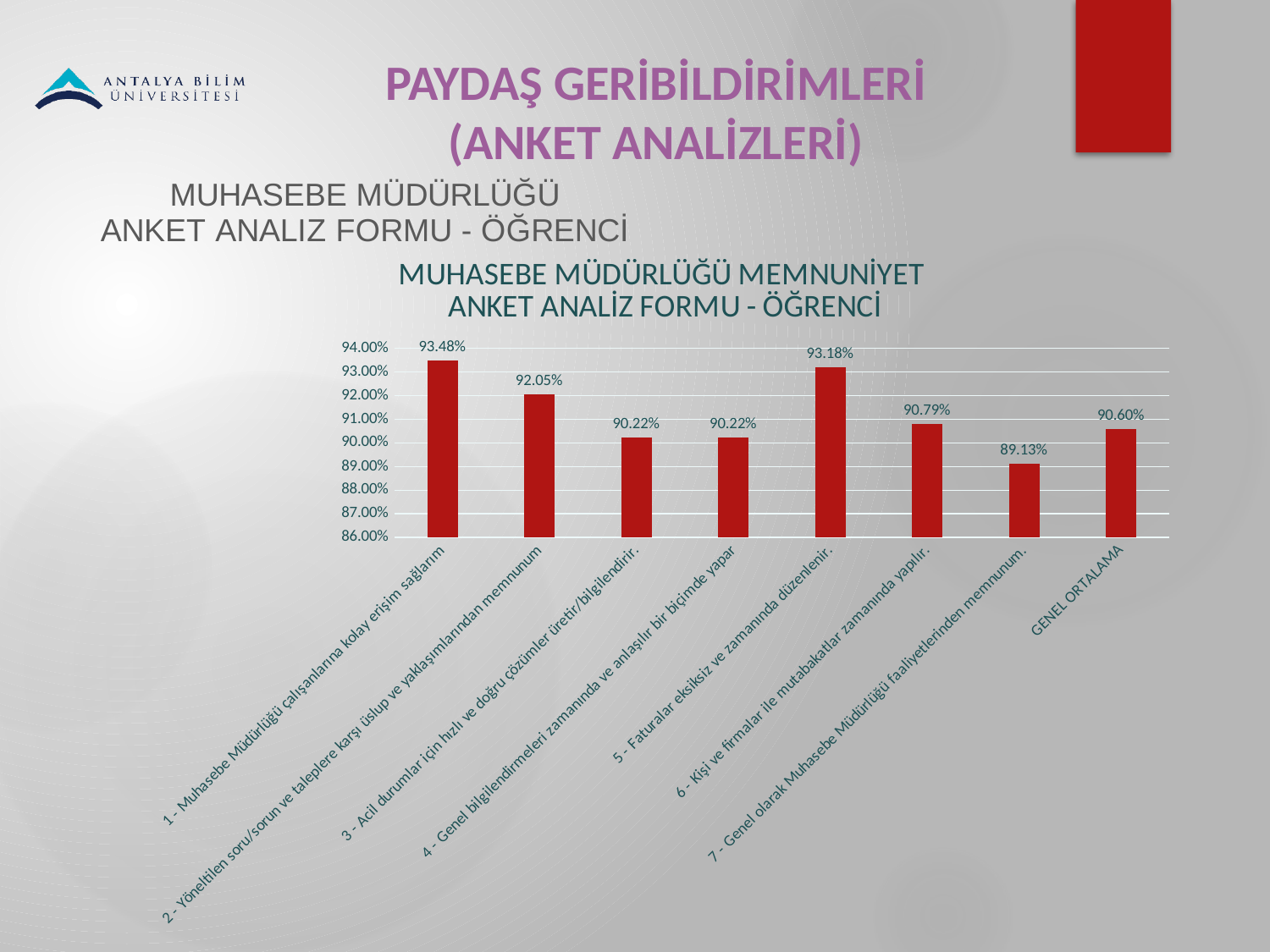
Which category has the highest value? 1 - Muhasebe Müdürlüğü çalışanlarına kolay erişim sağlarım What kind of chart is shown on the slide? Bar chart What is the difference between the highest value (93.48%) and the lowest value (89.13%)? 4.35% What is the value for item 7 (Genel olarak Muhasebe Müdürlüğü faaliyetlerinden memnunum.)? 89.13% Which category has the lowest value? 7 - Genel olarak Muhasebe Müdürlüğü faaliyetlerinden memnunum. What is the title of the chart? MUHASEBE MÜDÜRLÜĞÜ MEMNUNİYET ANKET ANALİZ FORMU - ÖĞRENCİ How many bars are shown in the chart? 8 What is the value for item 2 (Yöneltilen soru/sorun ve taleplere karşı üslup ve yaklaşımlarından memnunum)? 92.05% What is the value for item 5 (Faturalar eksiksiz ve zamanında düzenlenir.)? 93.18% Is the value for item 7 greater or less than 90.00%? less What is the value for GENEL ORTALAMA? 90.60% Which is larger: the value for item 2 or the value for item 6? Item 2 (92.05%)